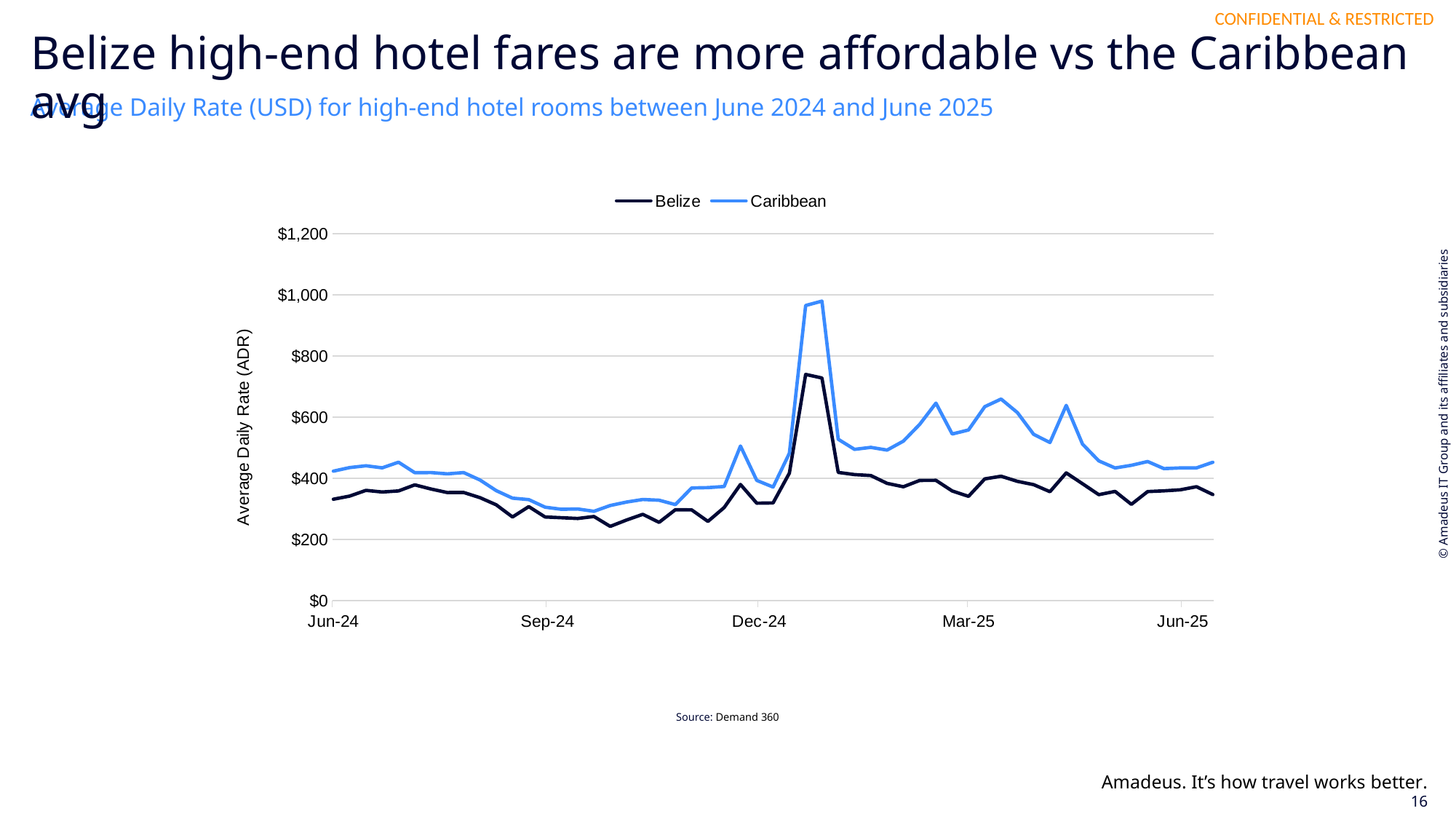
Is the value for Belize at Jun-24 greater or less than $400? less What is the label on the vertical axis of the chart? Average Daily Rate (ADR) What are the two series named in the chart legend? Belize and Caribbean Is the peak value of the Caribbean line greater or less than $800? greater Which series reaches the highest value on the chart? Caribbean Is the value for Belize at Sep-24 greater or less than $400? less What kind of chart is shown on the slide? line chart Does the Belize line rise or fall between Jun-24 and Sep-24? fall At the peak around the start of 2025, which series has the larger value, Belize or Caribbean? Caribbean How many series does the chart legend list? 2